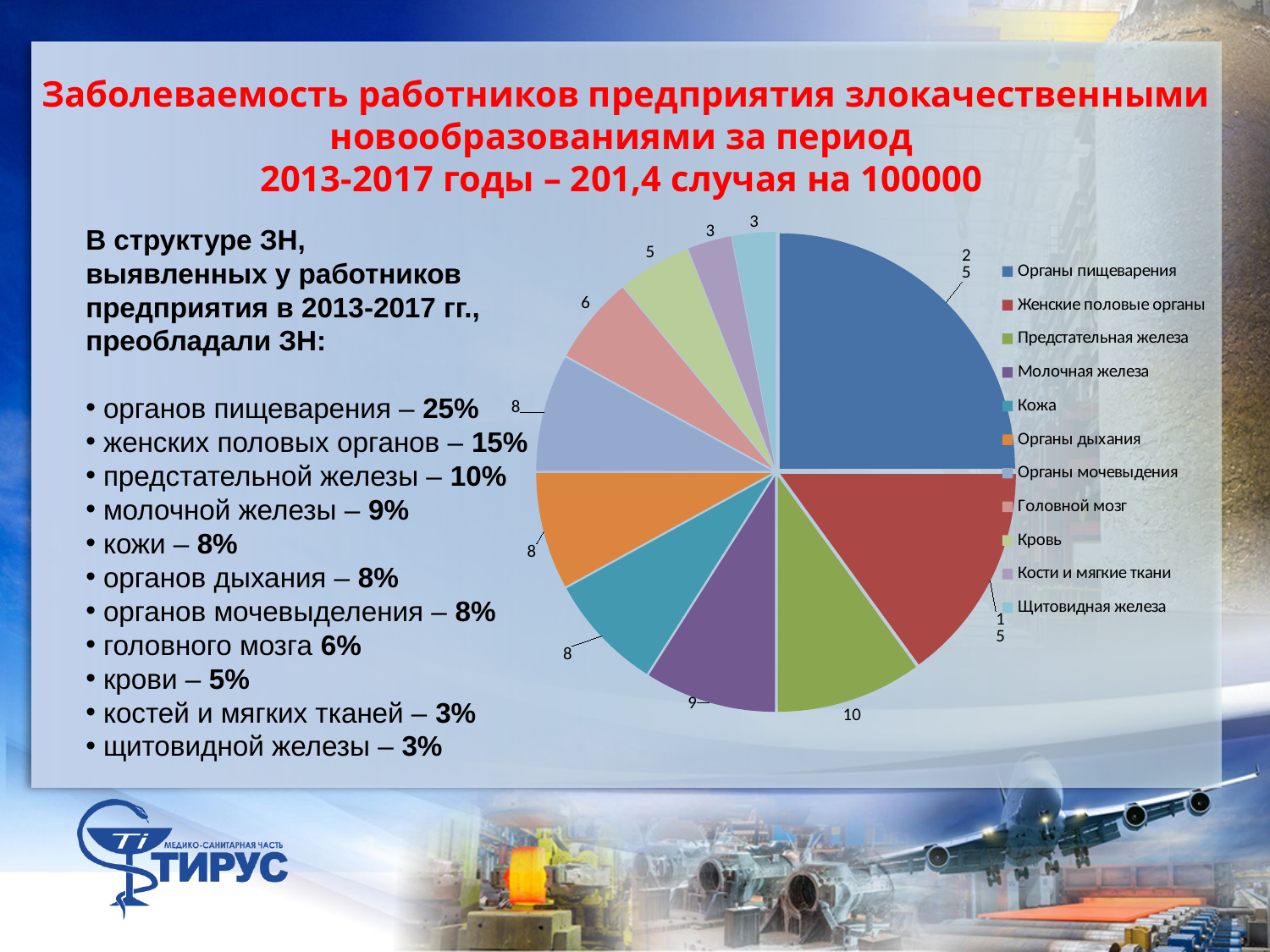
What is the value shown for Предстательная железа in the pie chart? 10 What is the value shown for Органы пищеварения in the pie chart? 25 What is the value shown for Головной мозг in the pie chart? 6 Which category has the largest slice in the pie chart? Органы пищеварения What is the value shown for Кровь in the pie chart? 5 What colour is the Органы пищеварения slice in the pie chart? blue What is the difference between the values for Органы пищеварения and Женские половые органы in the pie chart? 10 What kind of chart is shown on the slide? pie chart How many entries does the legend of the pie chart list? 11 What share of the pie does Молочная железа represent? 9% How many categories (slices) does the pie chart have? 11 Which is larger in the pie chart: Женские половые органы or Молочная железа? Женские половые органы